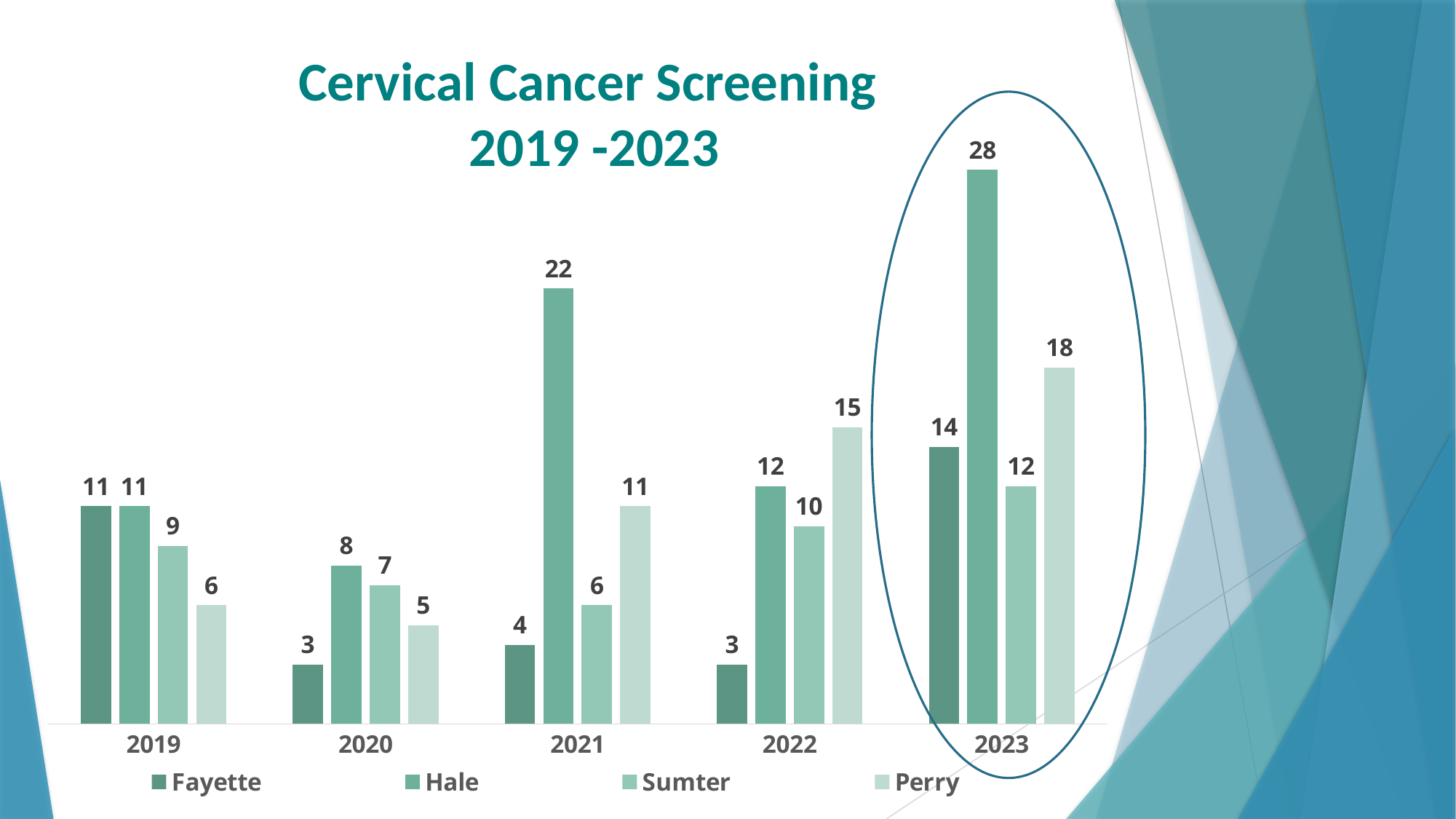
Which is larger in 2022, Sumter or Perry? Perry What is the value for Perry in 2022? 15 What kind of chart is shown? Bar chart Which year has the highest value for Hale? 2023 What is the value for Fayette in 2020? 3 How many years are shown on the x axis? 5 What is the title of the chart? Cervical Cancer Screening 2019 -2023 Which year has the lowest value for Perry? 2020 What is the value for Hale in 2023? 28 Does the value for Hale rise or fall from 2022 to 2023? Rise How many series does the legend list? 4 What is the difference between Hale and Fayette in 2021? 18